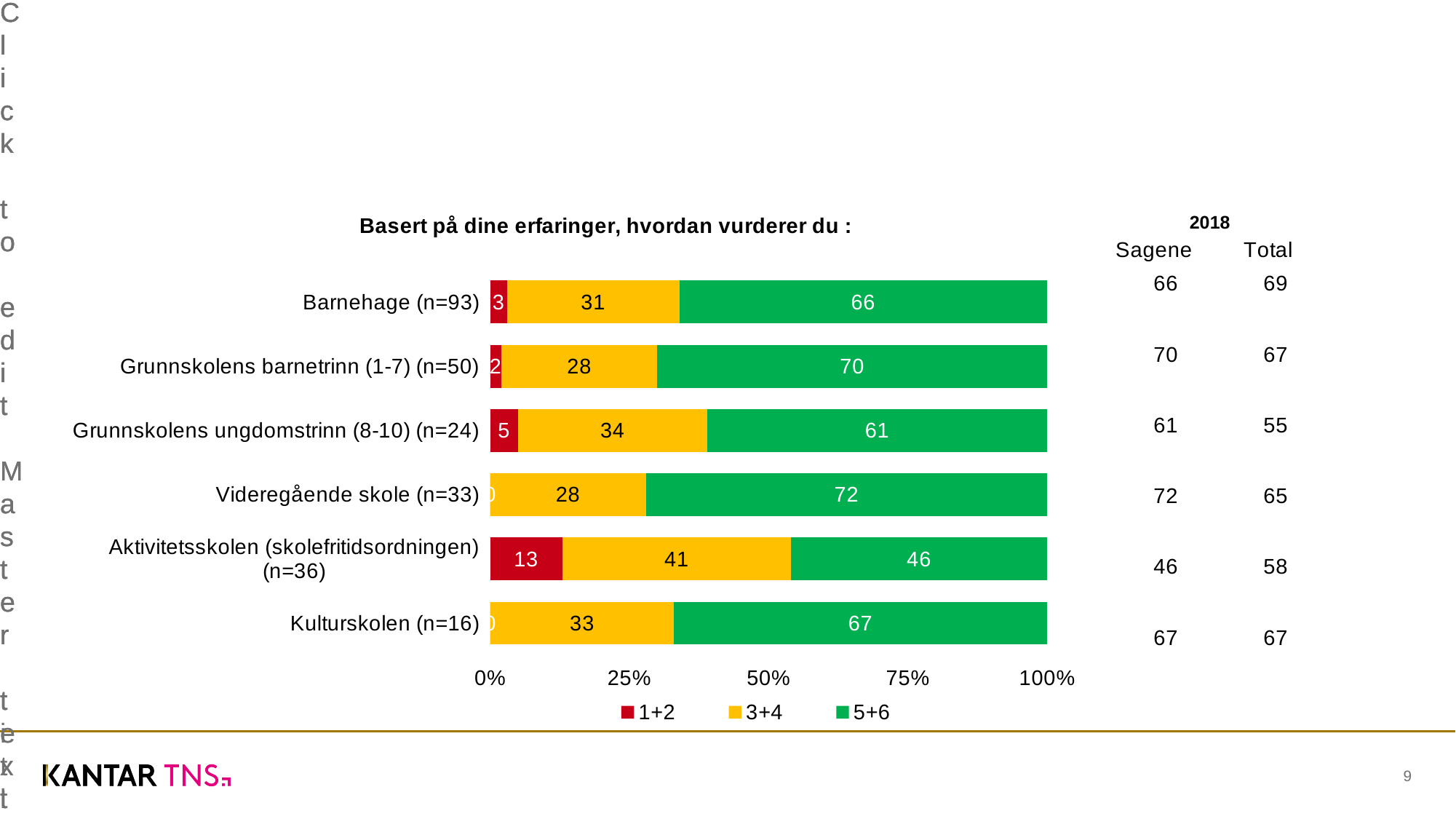
What is the value of the 1+2 series for Grunnskolens ungdomstrinn (8-10) (n=24)? 5 How many categories are shown in the chart? 6 What is the value of the 3+4 series for Aktivitetsskolen (skolefritidsordningen) (n=36)? 41 How many series does the legend list? 3 What is the value of the 5+6 series for Barnehage (n=93)? 66 What is the title of the chart? Basert på dine erfaringer, hvordan vurderer du : Which is larger: the 3+4 value for Grunnskolens ungdomstrinn (8-10) (n=24) or the 3+4 value for Barnehage (n=93)? Grunnskolens ungdomstrinn (8-10) (n=24) Which category has the highest value for the 1+2 series? Aktivitetsskolen (skolefritidsordningen) (n=36) Which category has the highest value for the 5+6 series? Videregående skole (n=33) What kind of chart is shown on the slide? Stacked bar chart Which category has the lowest value for the 5+6 series? Aktivitetsskolen (skolefritidsordningen) (n=36) What is the difference between the 5+6 values for Videregående skole (n=33) and Aktivitetsskolen (skolefritidsordningen) (n=36)? 26